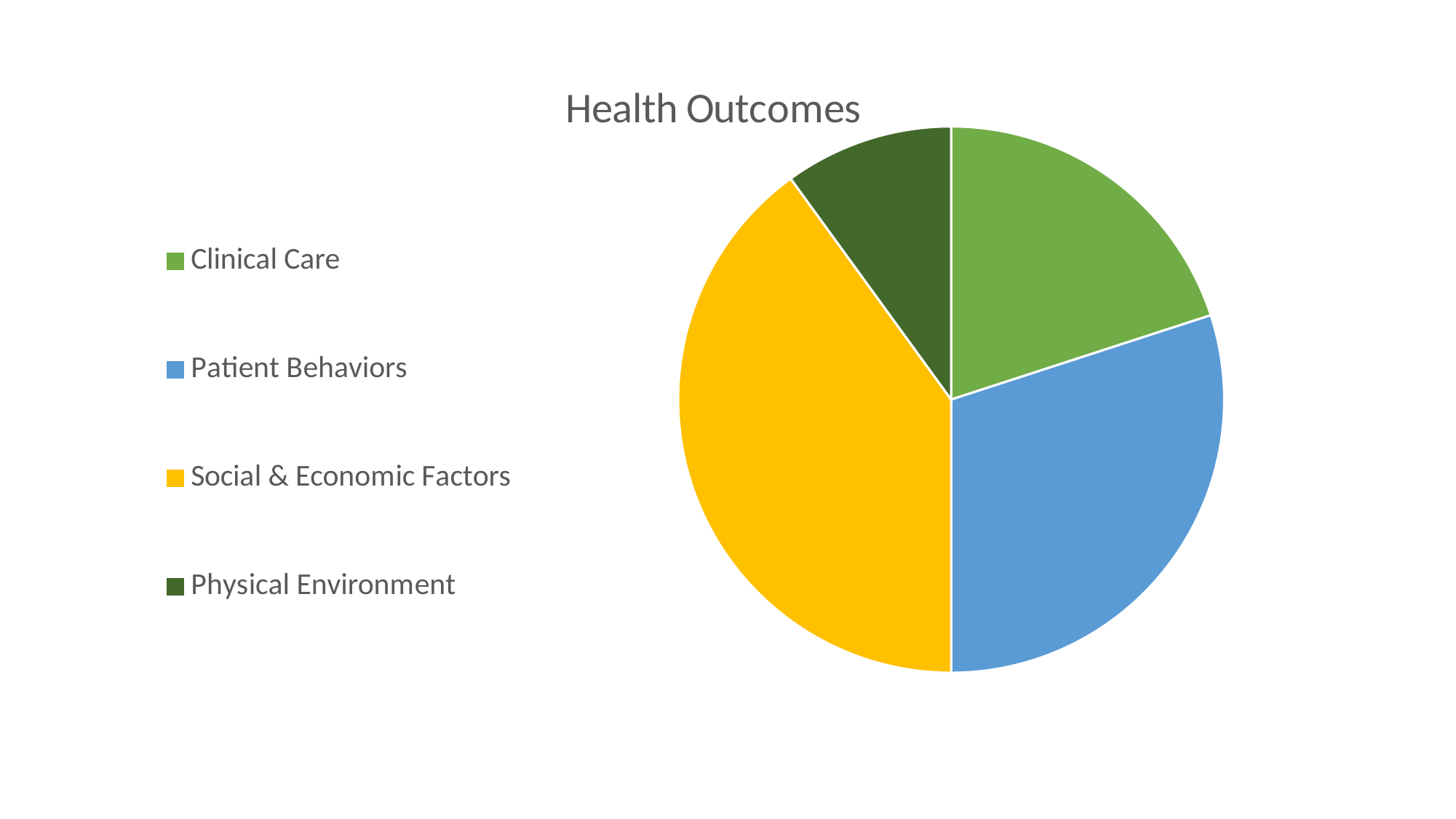
Which category has the largest slice of the pie? Social & Economic Factors Which slice is larger, Patient Behaviors or Clinical Care? Patient Behaviors Which slice is larger, Clinical Care or Physical Environment? Clinical Care Which colour represents Social & Economic Factors in the pie chart? yellow What kind of chart is shown on the slide? pie chart How many slices does the pie chart have? 4 Which slice is larger, Social & Economic Factors or Patient Behaviors? Social & Economic Factors What is the title of the chart? Health Outcomes How many entries does the legend list? 4 Which category has the smallest slice of the pie? Physical Environment